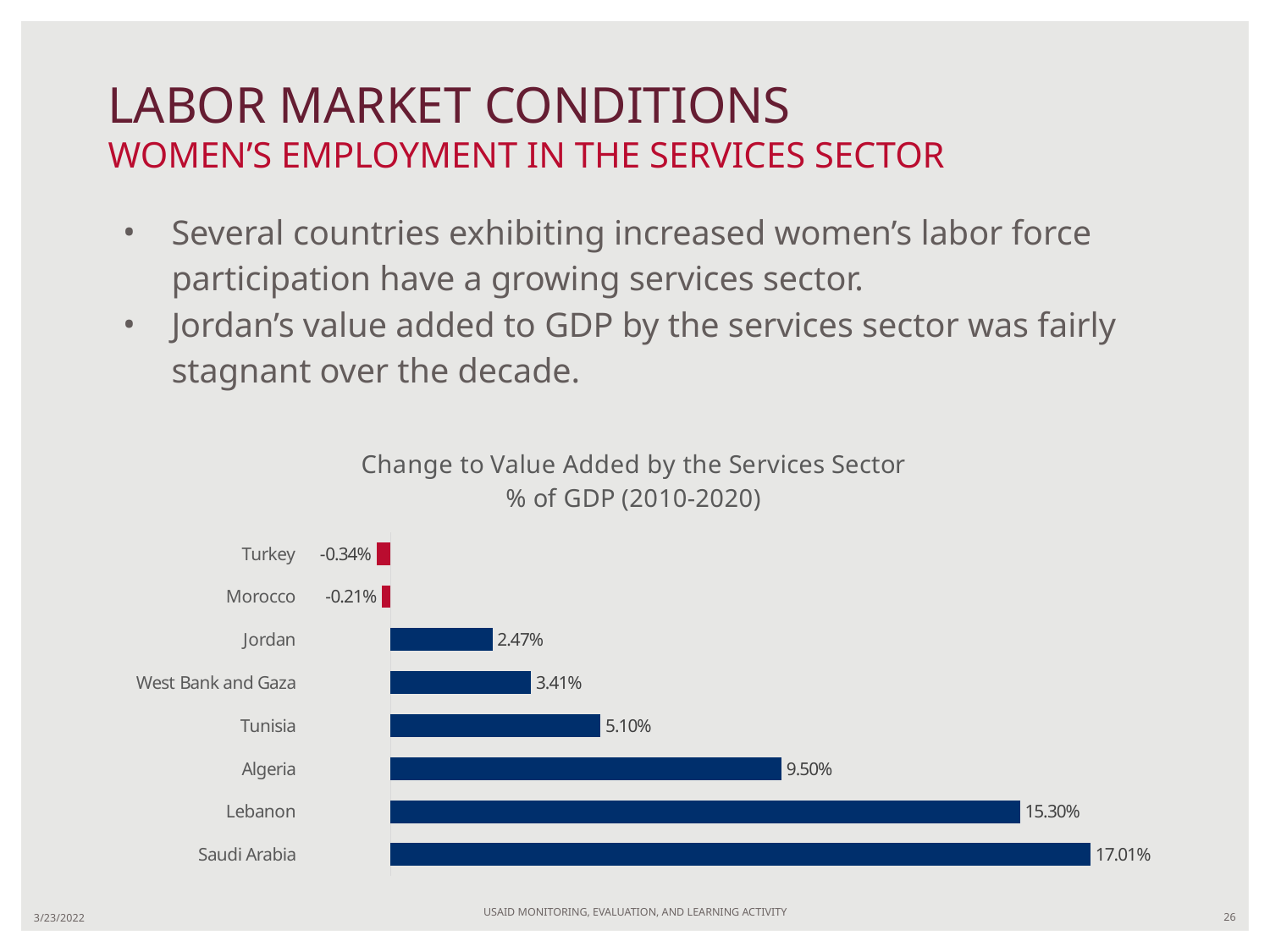
What is the difference between the values for Lebanon and Algeria? 5.80% What is the value shown for Jordan? 2.47% What is the value shown for Turkey? -0.34% What colour are the bars for countries with negative values? Red Which country has the highest change to value added by the services sector? Saudi Arabia What is the change to value added by the services sector for Saudi Arabia? 17.01% Which country has the lowest change to value added by the services sector? Turkey How many countries show a negative change? 2 How many countries are shown in the chart? 8 What kind of chart is shown on the slide? Bar chart Which has a larger value, Tunisia or West Bank and Gaza? Tunisia What is the title of the chart? Change to Value Added by the Services Sector % of GDP (2010-2020)